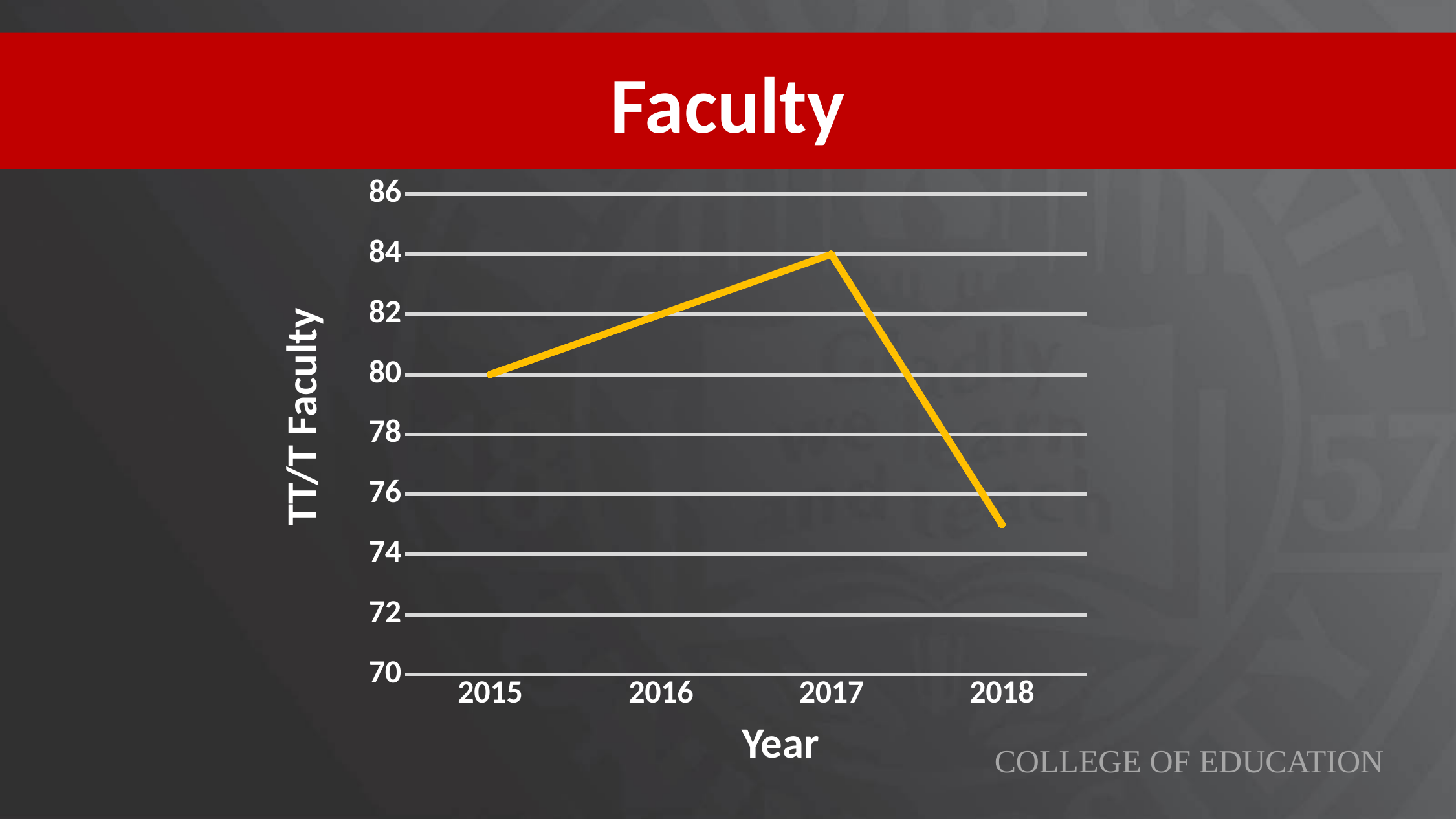
Which year has the highest TT/T Faculty value? 2017 What is the TT/T Faculty value for 2016? 82 What is the TT/T Faculty value for 2015? 80 Is the TT/T Faculty value for 2018 greater or less than 74? greater Which year has the lowest TT/T Faculty value? 2018 Which year has a larger TT/T Faculty value, 2015 or 2018? 2015 What kind of chart is shown on the slide? Line chart What is the label of the y axis? TT/T Faculty How many years are plotted on the x axis? 4 Is the TT/T Faculty value for 2018 greater or less than 76? less What is the TT/T Faculty value for 2017? 84 What is the difference between the TT/T Faculty values for 2017 and 2015? 4